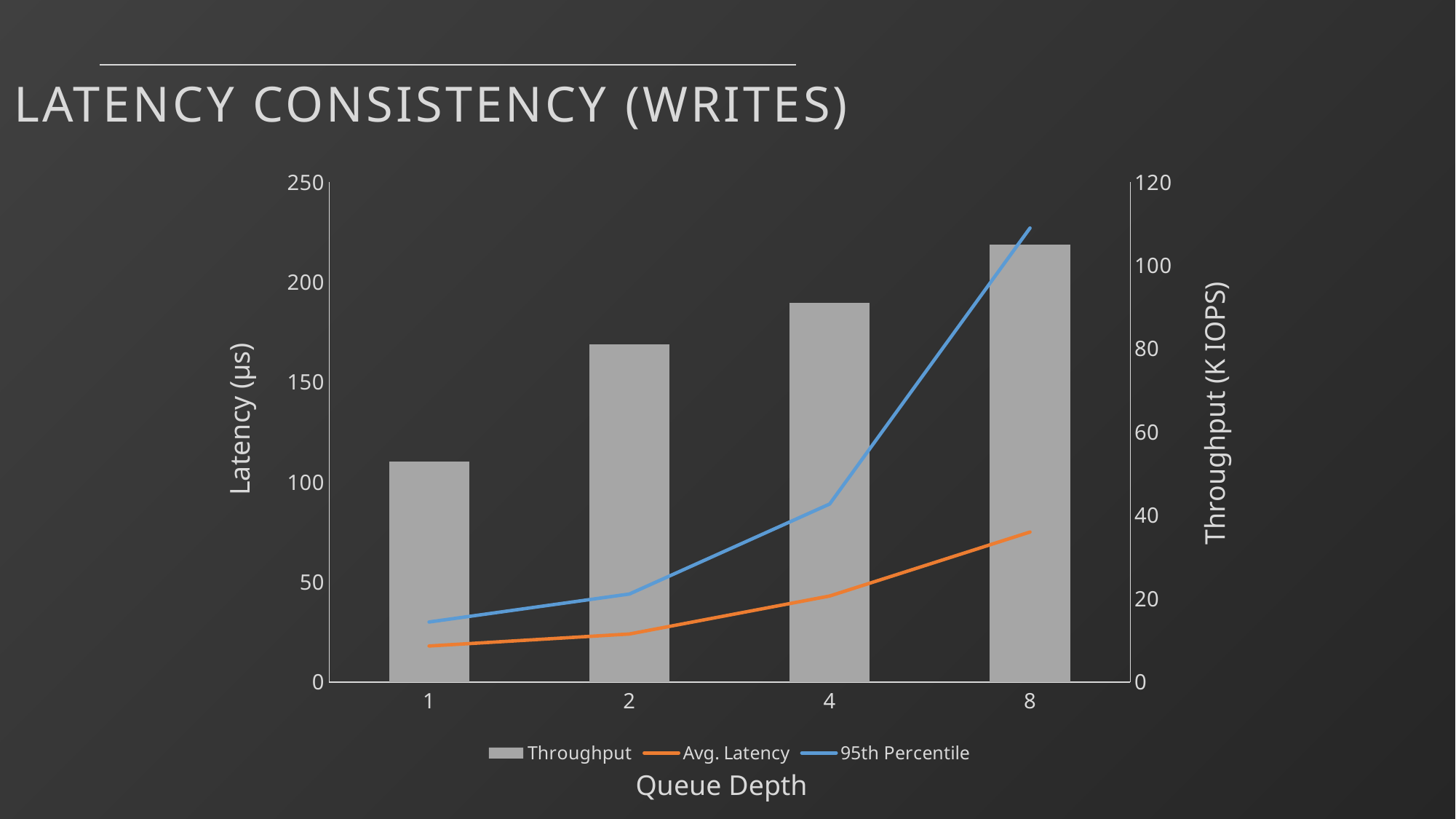
What is the label of the left vertical axis? Latency (µs) Does the 95th Percentile line rise or fall as queue depth increases? Rises At which queue depth is Throughput highest? 8 At which queue depth is Throughput lowest? 1 How many queue depth categories are plotted on the x axis? 4 What kind of chart is shown on the slide? A combined bar and line chart Is the 95th Percentile value at queue depth 8 greater or less than 200? greater How many series does the legend list? 3 What is the title of the x axis? Queue Depth Is the Throughput value at queue depth 1 greater or less than 60? less At queue depth 4, which is larger: the 95th Percentile or the Avg. Latency? 95th Percentile Is the Avg. Latency value at queue depth 8 greater or less than 100? less